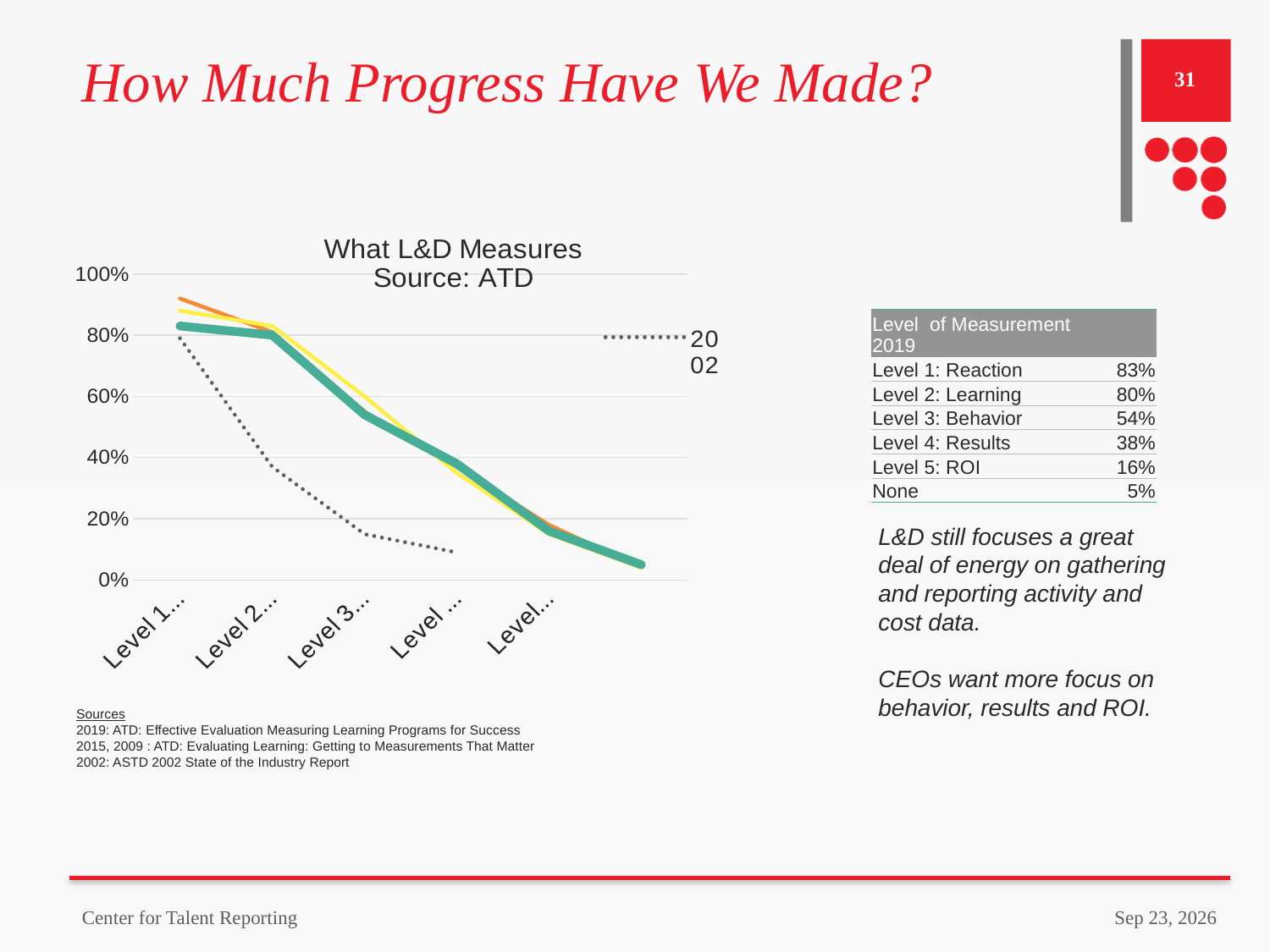
Is the value of the dotted 2002 line at Level 3 greater or less than 20%? less Is the value of the thick green line at Level 5 greater or less than 20%? less What is the title of the chart? What L&D Measures Source: ATD Is the value of the thick green line at Level 1 greater or less than 60%? greater For the thick green line, which level has the lowest value? Level 5 Which year is labelled on the dotted line in the chart? 2002 What kind of chart is shown on the slide? line chart Do the values in the chart rise or fall from Level 1 to Level 5? fall At Level 2, is the dotted 2002 line higher or lower than the thick green line? lower